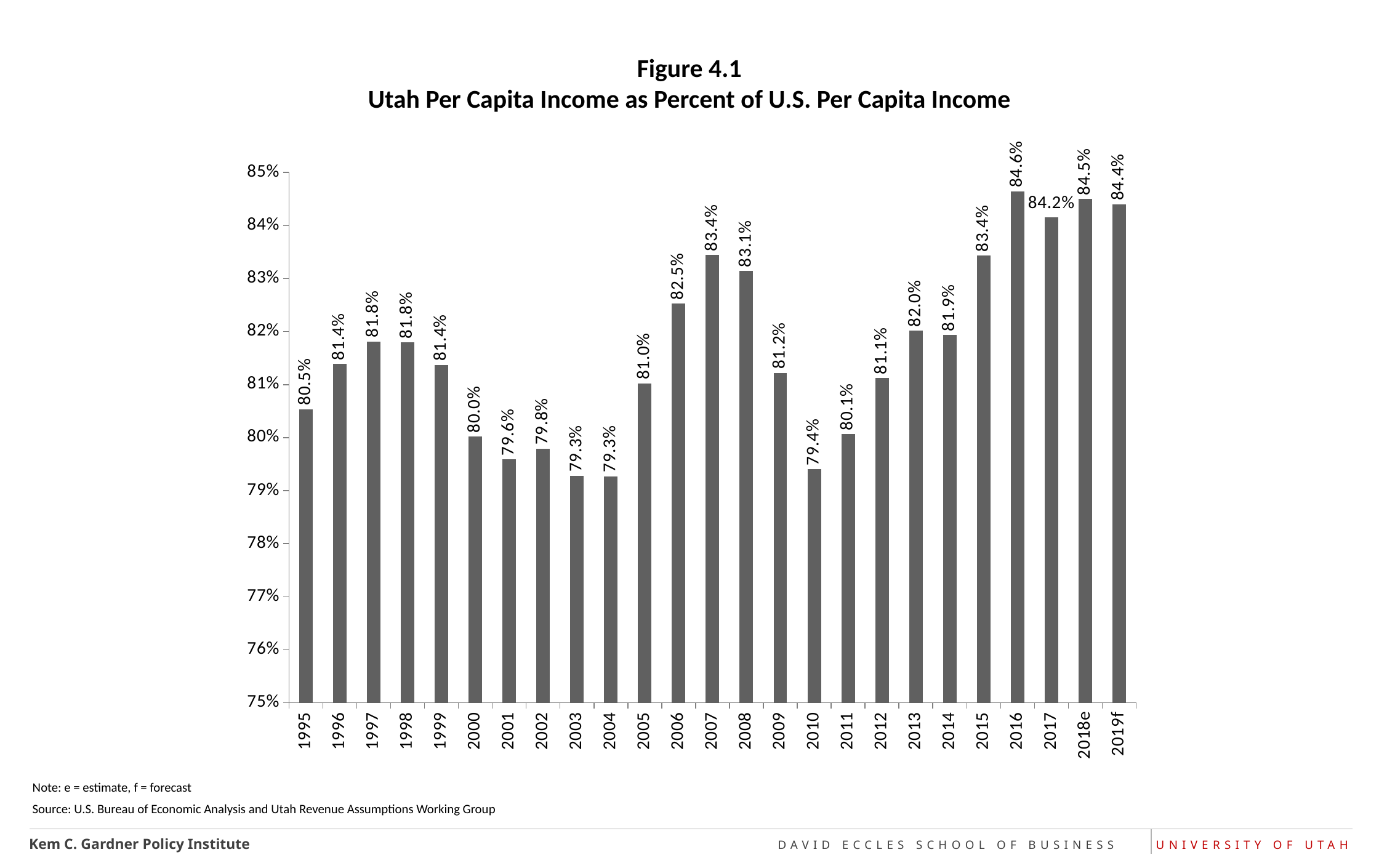
What is the value for 2018e? 84.5% What is the difference between the values for 2006 and 2005? 1.5% What is the difference between the values for 2016 and 2010? 5.2% What is the value for 1995? 80.5% Do the values rise or fall from 2010 to 2016? Rise What is the value for 2007? 83.4% Which is larger, the value for 2008 or the value for 2013? 2008 How many years are shown on the x axis? 25 What kind of chart is this? Bar chart What is the value for 2010? 79.4% Which year has the highest value? 2016 What is the lowest value shown on the chart? 79.3%